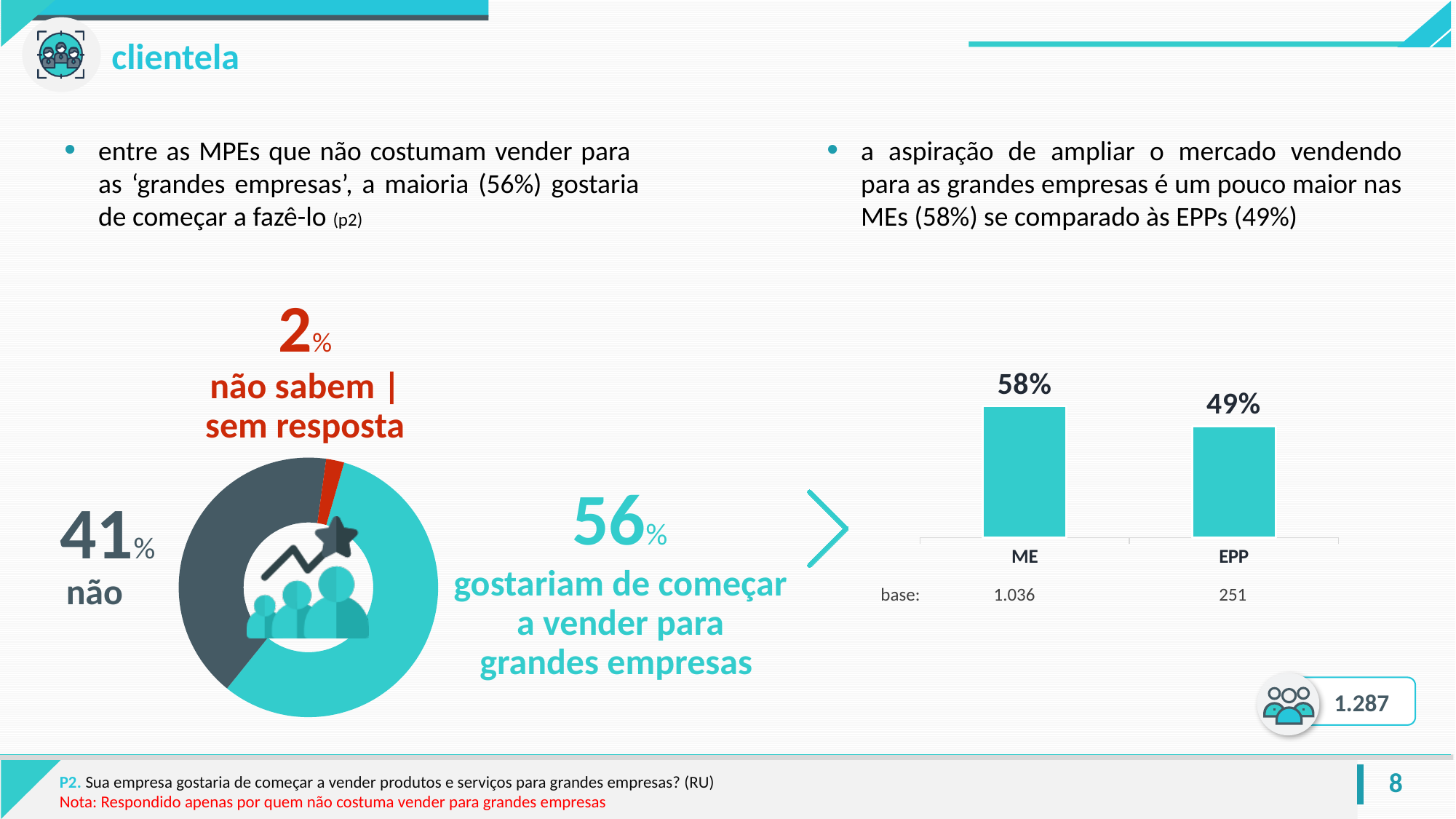
In the bar chart on the right, which category has the higher value, ME or EPP? ME In the donut chart on the left, which response has the smallest share? não sabem | sem resposta In the bar chart on the right, what is the base (number of respondents) shown for EPP? 251 In the donut chart on the left, what share of respondents is 'não sabem | sem resposta'? 2% In the bar chart on the right, what is the value for ME? 58% In the bar chart on the right, what is the value for EPP? 49% What kind of chart is shown on the right side of the slide? Bar chart In the donut chart on the left, what share of respondents would like to start selling to large companies (gostariam de começar a vender para grandes empresas)? 56% In the bar chart on the right, what is the base (number of respondents) shown for ME? 1.036 In the bar chart on the right, how many categories are shown? 2 In the donut chart on the left, what share of respondents answered 'não'? 41% In the bar chart on the right, what is the difference between the values for ME and EPP? 9 percentage points